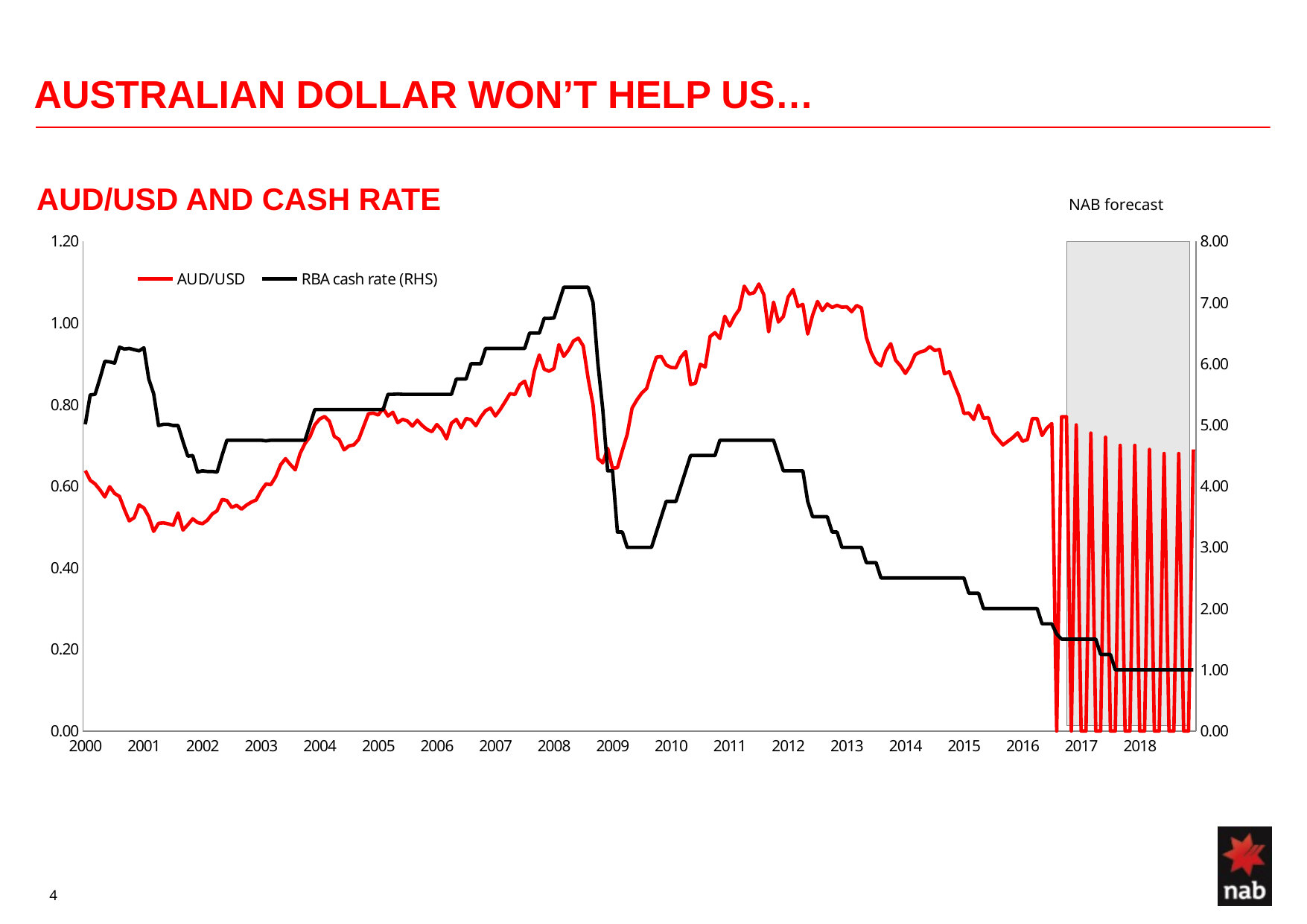
In which year does the RBA cash rate reach its highest level? 2008 What does the shaded area at the right of the chart represent, according to its label? NAB forecast Is the RBA cash rate at its 2008 peak greater or less than 7.00? greater Does the RBA cash rate rise or fall between 2011 and 2016? fall What kind of chart is shown on the slide? line chart Does the AUD/USD exchange rate rise or fall between 2001 and 2008? rise Is the AUD/USD value in 2001 greater or less than 0.60? less Which is higher: the RBA cash rate in 2000 or in 2005? 2000 Is the peak value of AUD/USD in 2011 greater or less than 1.00? greater How many series does the legend list? 2 What is the title of the chart? AUD/USD AND CASH RATE In which year is the AUD/USD exchange rate at its lowest? 2001